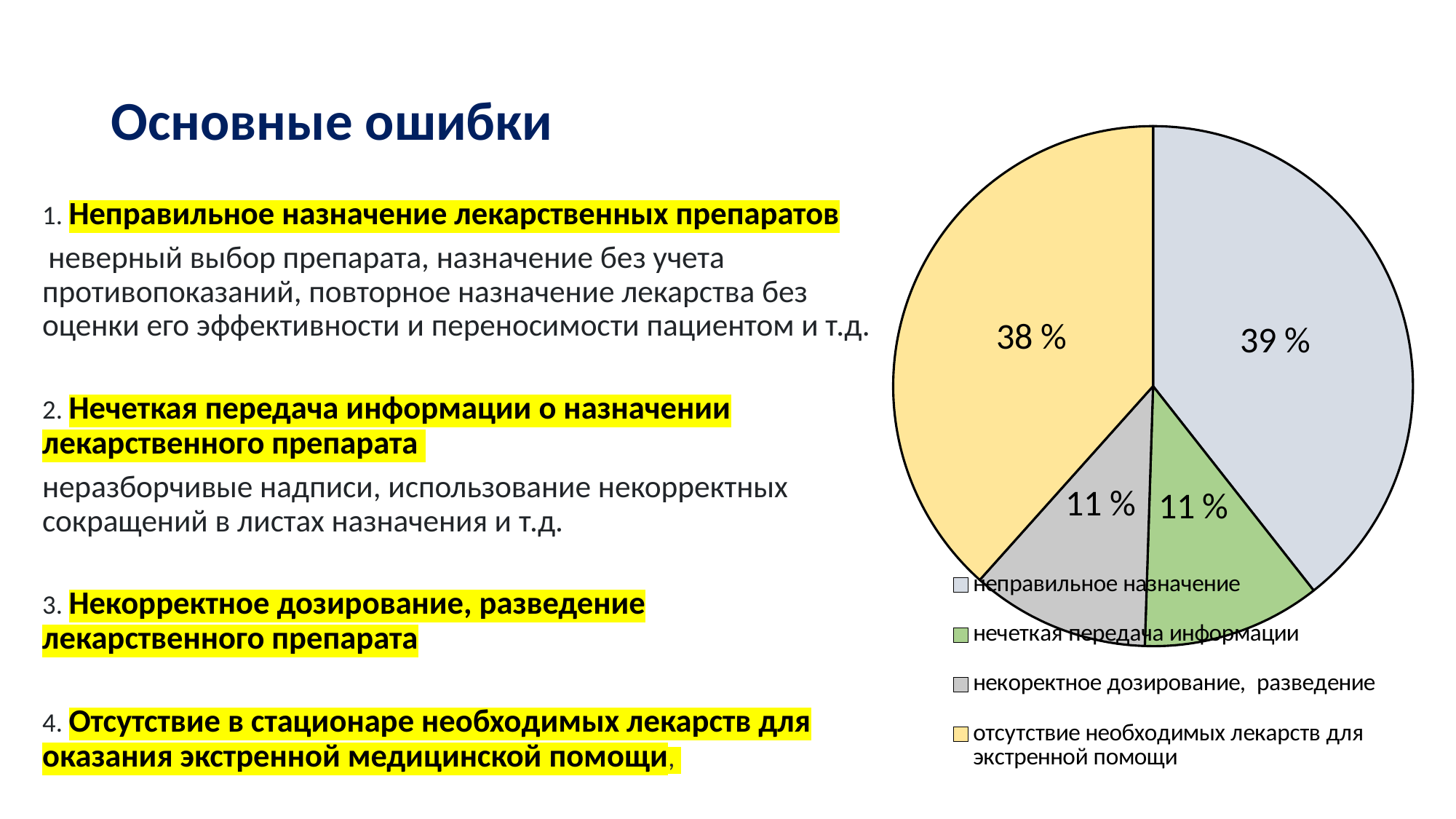
What share of the pie does "отсутствие необходимых лекарств для экстренной помощи" have? 38 % What share of the pie does "неправильное назначение" have? 39 % What share of the pie does "некоректное дозирование, разведение" have? 11 % What is the combined share of "нечеткая передача информации" and "некоректное дозирование, разведение"? 22 % Which is larger: the share of "неправильное назначение" or the share of "нечеткая передача информации"? неправильное назначение How many entries does the legend of the pie chart list? 4 What kind of chart is shown on the slide? pie chart What colour is the slice for "отсутствие необходимых лекарств для экстренной помощи"? yellow How many slices does the pie chart have? 4 Which category has the largest slice of the pie chart? неправильное назначение What is the difference between the shares of "неправильное назначение" and "отсутствие необходимых лекарств для экстренной помощи"? 1 %